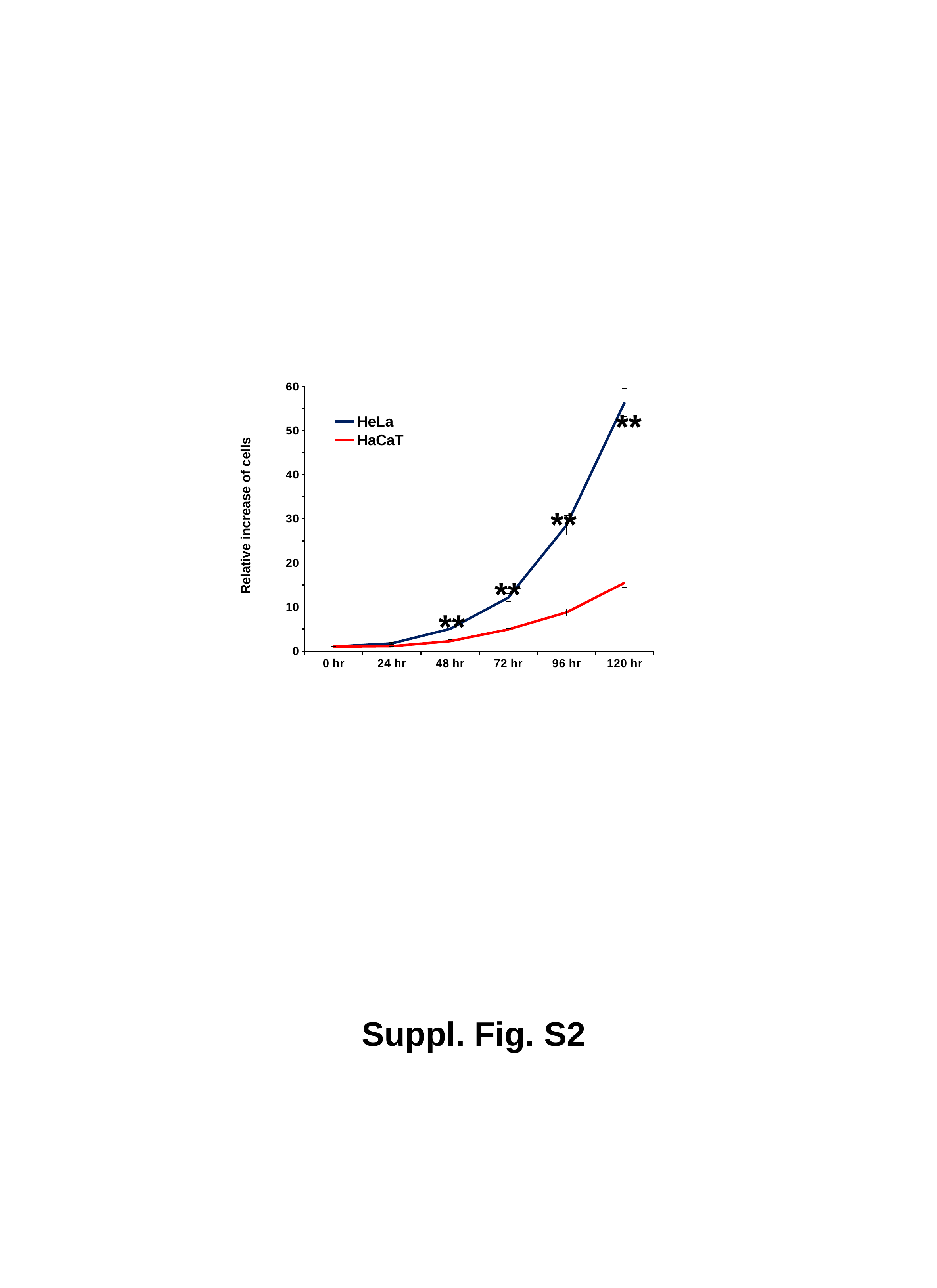
Is the HaCaT value at 72 hr greater or less than 10? less How many time points are plotted along the x axis? 6 Is the HaCaT value at 120 hr greater or less than 20? less What is the label of the y axis? Relative increase of cells At which time point is the HaCaT value lowest? 0 hr How many series does the legend list? 2 At 120 hr, which series has the larger value, HeLa or HaCaT? HeLa What kind of chart is shown on the slide? line chart Which series is drawn in red? HaCaT Do the HeLa values rise or fall from 0 hr to 120 hr? rise At which time point is the HeLa value highest? 120 hr Is the HeLa value at 120 hr greater or less than 50? greater